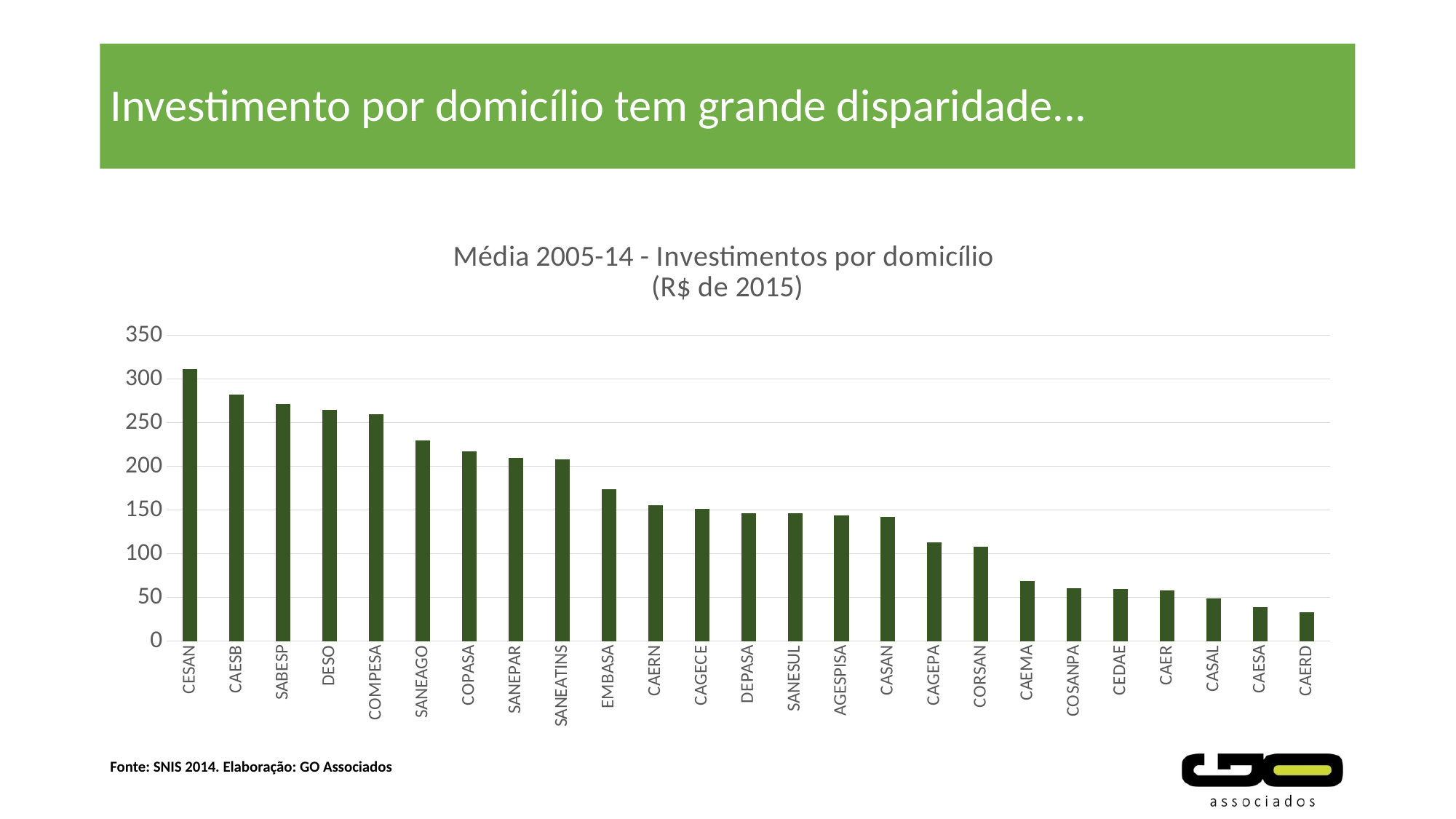
What is the title of the chart? Média 2005-14 - Investimentos por domicílio (R$ de 2015) What kind of chart is shown on the slide? bar chart Which company has the lowest average investment per household? CAERD Which company has the highest average investment per household? CESAN Is the value for CAERD greater or less than 50? less Do the values rise or fall from left to right along the x axis? fall Is the value for EMBASA greater or less than 150? greater How many companies are shown on the x axis? 25 Is the value for SANEAGO greater or less than 200? greater Which has a higher value, EMBASA or CAERN? EMBASA